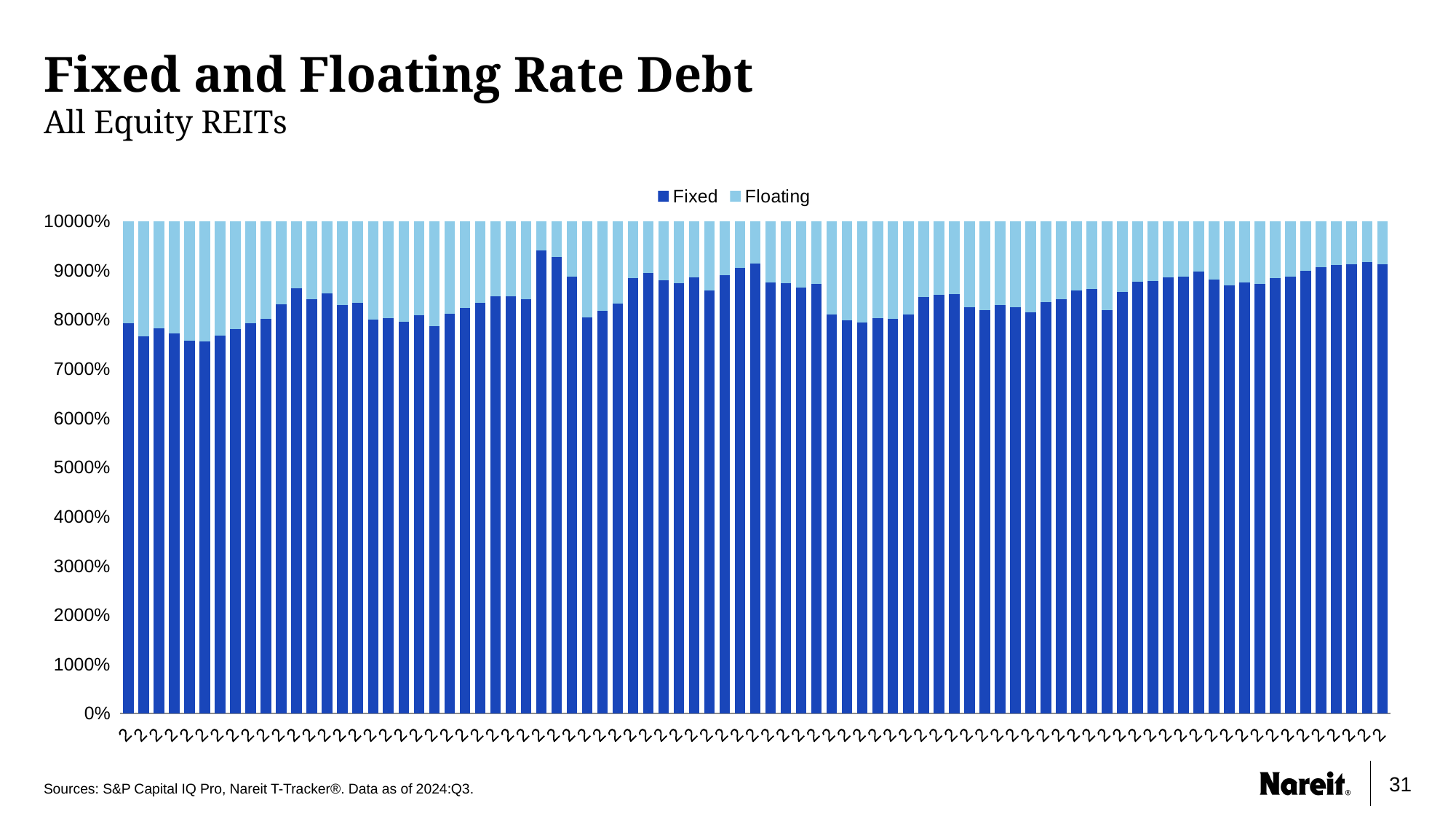
What total does each stacked bar reach on the y axis? 10000% What are the two series named in the legend? Fixed and Floating Which series occupies the larger portion of every bar, Fixed or Floating? Fixed How many series does the legend list? 2 Does the Fixed portion of the bars generally rise or fall from left to right across the chart? rise What kind of chart is shown on the slide? stacked bar chart Is the Fixed value for the leftmost bar greater or less than 7000%? greater Is the Fixed value for the rightmost bar greater or less than 8000%? greater What is the highest value shown on the y axis? 10000% What is the title of the slide containing the chart? Fixed and Floating Rate Debt